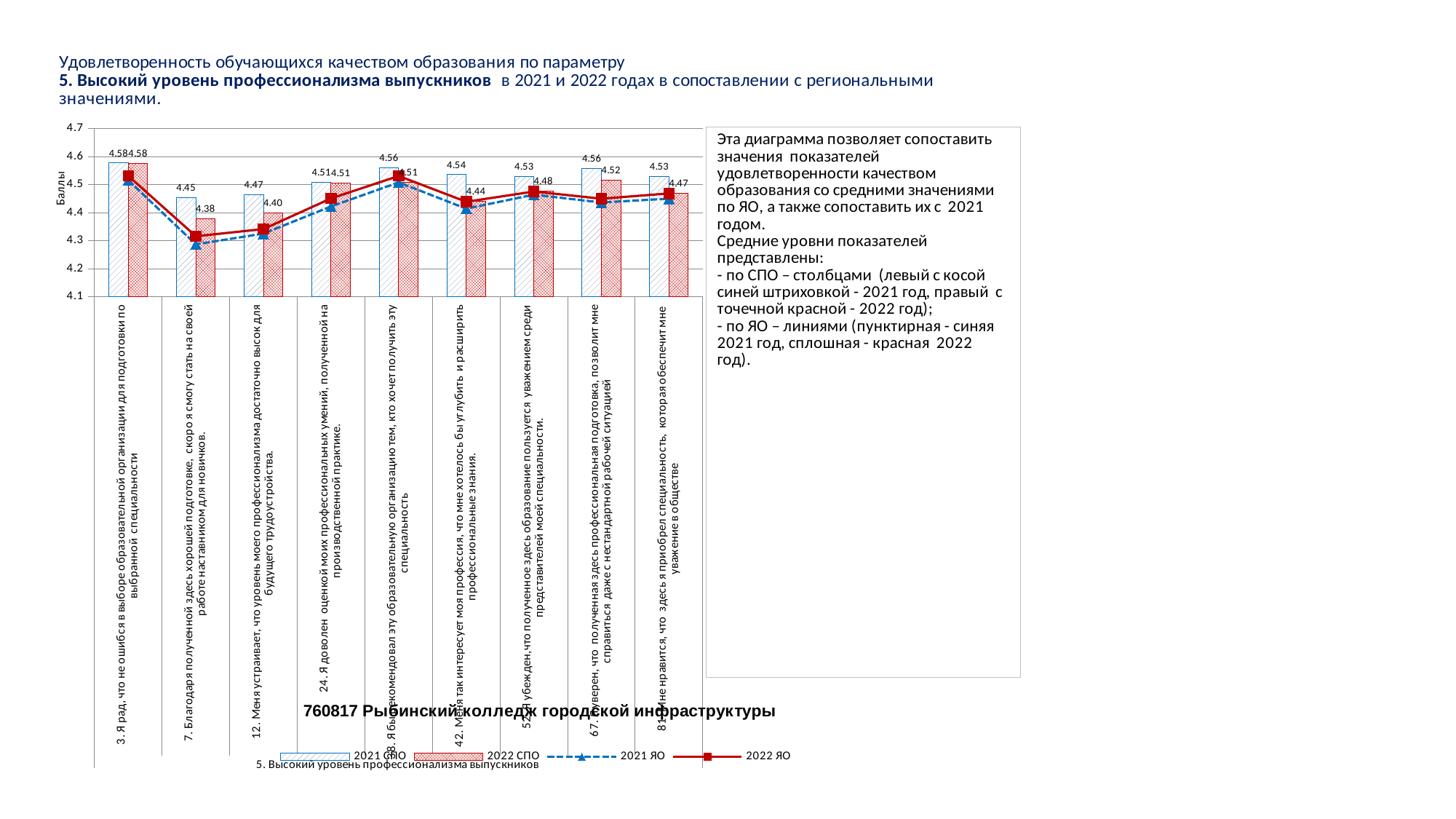
Which category has the highest 2022 СПО value? 3. Я рад, что не ошибся в выборе образовательной организации для подготовки по выбранной специальности What is the 2022 СПО value for category 42 ("Меня так интересует моя профессия...")? 4.44 For category 38 ("Я бы рекомендовал эту образовательную организацию..."), which is larger: the 2021 СПО value or the 2022 СПО value? 2021 СПО What is the 2021 СПО value for category 7 ("Благодаря полученной здесь хорошей подготовке...")? 4.45 What is the difference between the 2021 СПО and 2022 СПО values for category 42? 0.10 How many categories (questions) are plotted along the x axis? 9 What kind of chart is used to show the 2021 СПО and 2022 СПО series? Bar chart What is the title of the vertical axis? Баллы Which category has the lowest 2022 СПО value? 7. Благодаря полученной здесь хорошей подготовке, скоро я смогу стать на своей работе наставником для новичков How many series does the chart legend list? 4 Does the 2021 СПО value rise or fall from category 3 to category 7? fall Is the 2022 ЯО value for category 7 greater or less than 4.4? less